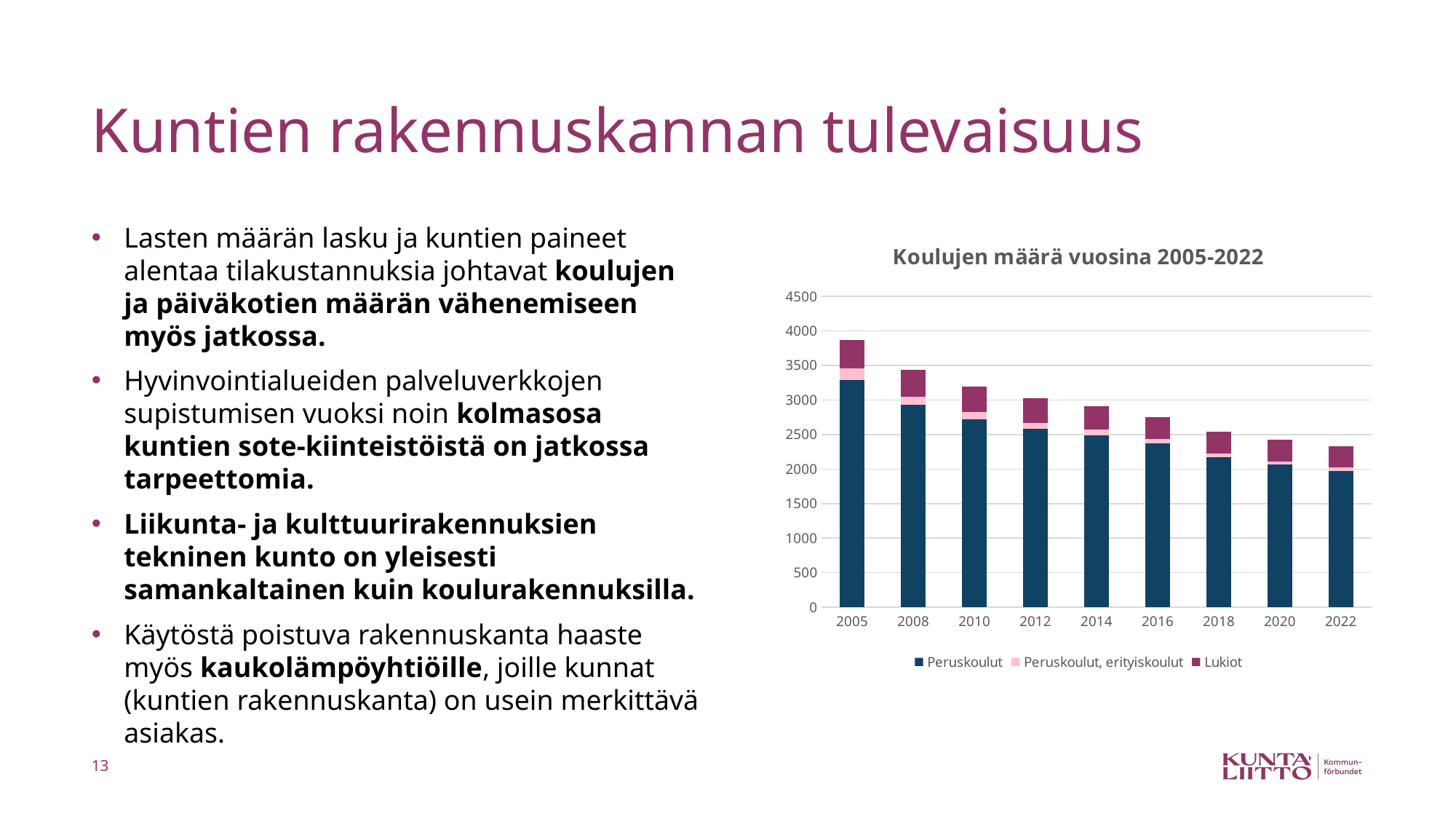
How many series does the chart legend list? 3 Which is larger, the total bar for 2005 or the total bar for 2022? 2005 What is the title of the chart? Koulujen määrä vuosina 2005-2022 Is the total bar for 2005 greater or less than 3500? greater Which year has the highest total number of schools in the chart? 2005 Do the total bar heights rise or fall from 2005 to 2022? Fall What kind of chart is shown on the slide? Stacked bar chart Which year has the lowest total number of schools in the chart? 2022 How many years are shown on the x axis of the chart? 9 Is the total bar for 2016 greater or less than 2500? greater Is the Peruskoulut value for 2005 greater or less than 3000? greater